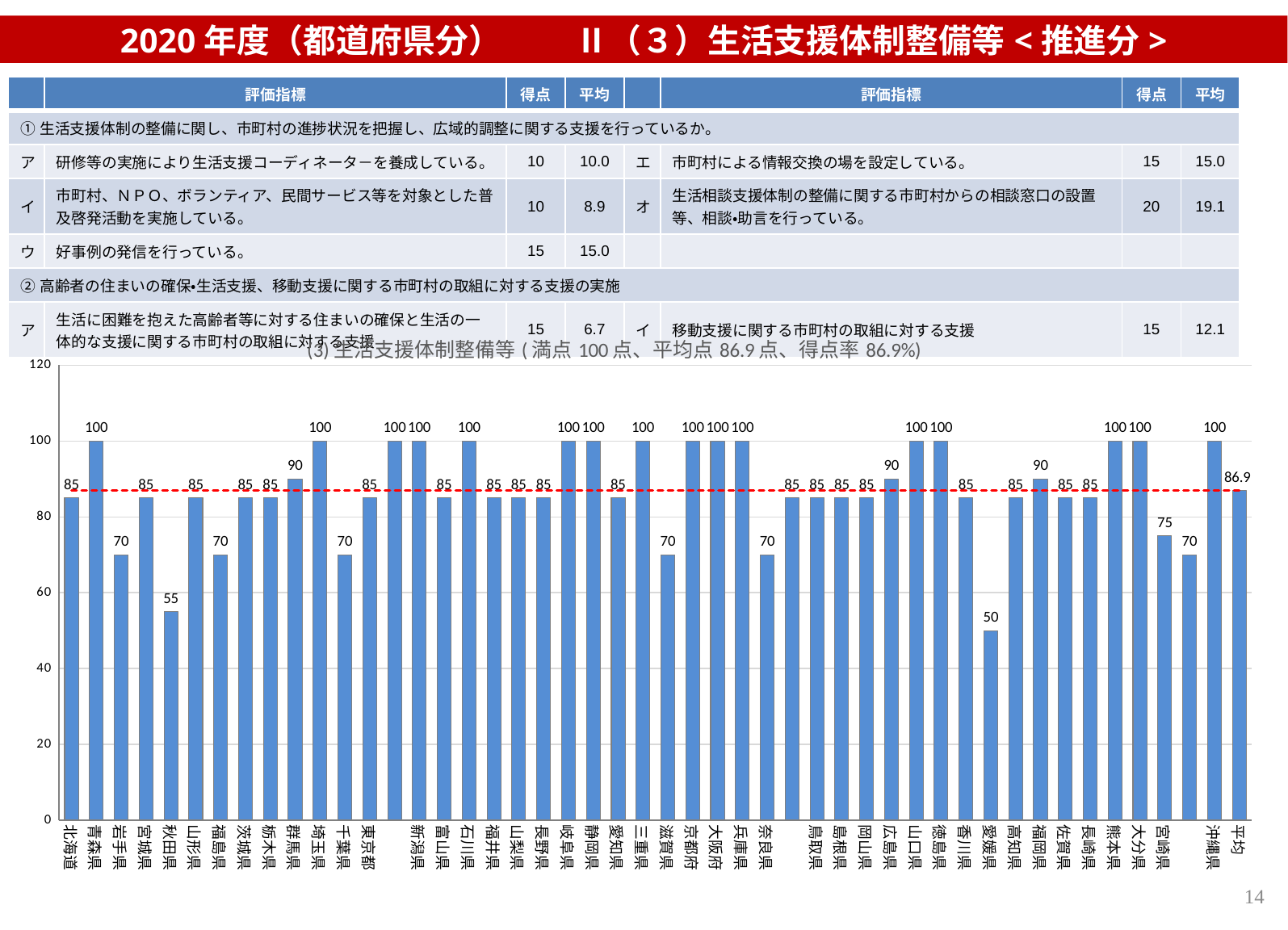
What is the value for 愛媛県 in the bar chart? 50 According to the chart title, what is the 平均点 (average score)? 86.9 点 Which has the larger value, 群馬県 or 千葉県? 群馬県 Which prefecture has the lowest value in the bar chart? 愛媛県 What is the value for 沖縄県 in the bar chart? 100 What is the difference between the values for 青森県 and 岩手県? 30 What kind of chart is shown on the slide? bar chart What is the value for 宮崎県 in the bar chart? 75 What is the value for 秋田県 in the bar chart? 55 What is the difference between the values for 秋田県 and 愛媛県? 5 Is the value for 福岡県 greater or less than 80? greater What is the value shown for 平均 (the last bar) in the chart? 86.9